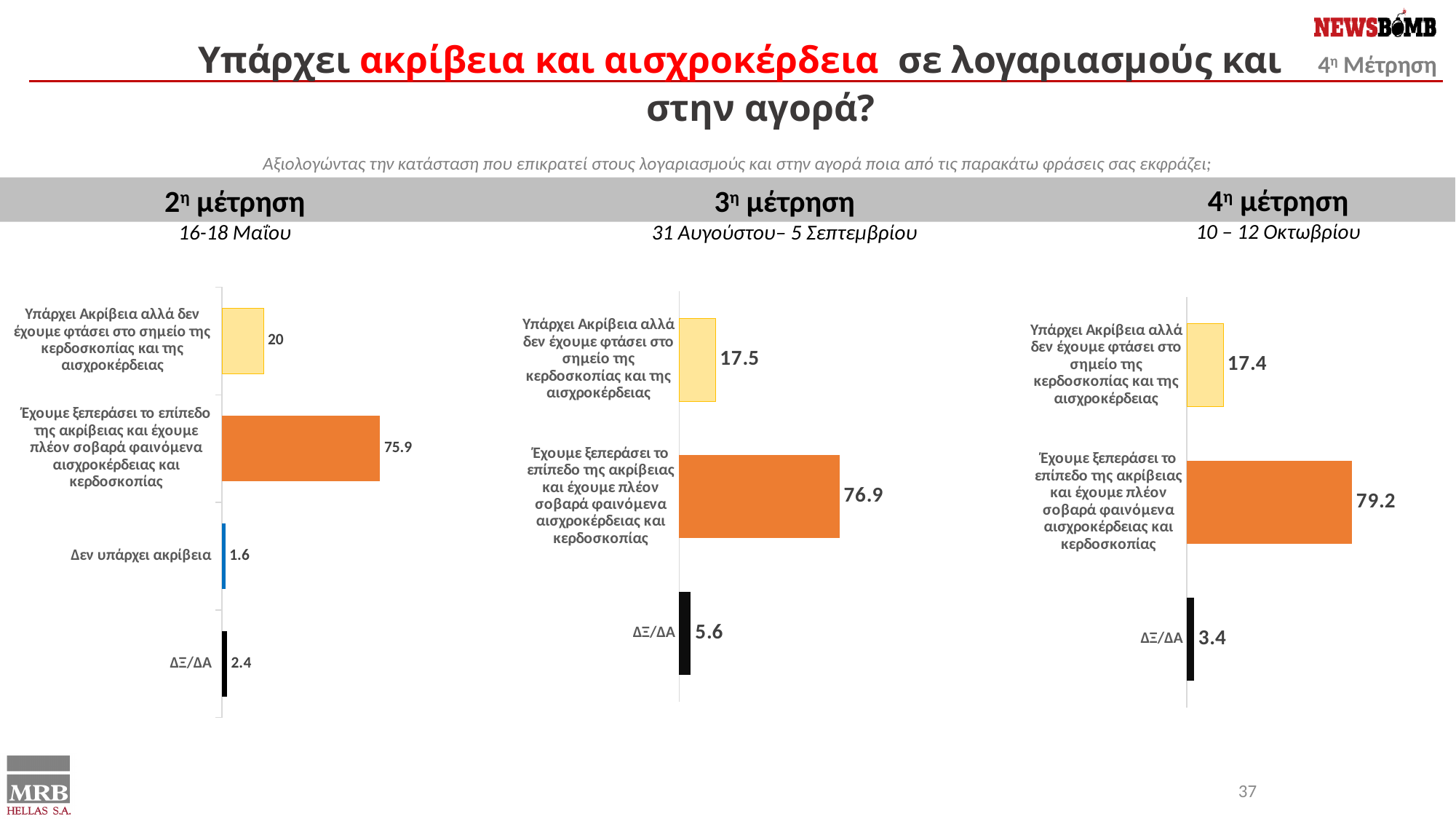
How many categories are shown in the 4η μέτρηση chart (right)? 3 In the 4η μέτρηση chart (right), what is the value for ΔΞ/ΔΑ? 3.4 In the 2η μέτρηση chart (left), what is the value for 'Έχουμε ξεπεράσει το επίπεδο της ακρίβειας και έχουμε πλέον σοβαρά φαινόμενα αισχροκέρδειας και κερδοσκοπίας'? 75.9 In the 4η μέτρηση chart (right), which category has the highest value? Έχουμε ξεπεράσει το επίπεδο της ακρίβειας και έχουμε πλέον σοβαρά φαινόμενα αισχροκέρδειας και κερδοσκοπίας In the 3η μέτρηση chart (middle), what is the value for 'Υπάρχει Ακρίβεια αλλά δεν έχουμε φτάσει στο σημείο της κερδοσκοπίας και της αισχροκέρδειας'? 17.5 Is the ΔΞ/ΔΑ value larger in the 3η μέτρηση chart (middle) or in the 4η μέτρηση chart (right)? 3η μέτρηση What type of chart is the 3η μέτρηση chart (middle)? Bar chart How many categories are shown in the 2η μέτρηση chart (left)? 4 In the 2η μέτρηση chart (left), which category has the lowest value? Δεν υπάρχει ακρίβεια In the 3η μέτρηση chart (middle), what is the difference between the value for 'Έχουμε ξεπεράσει το επίπεδο της ακρίβειας...' and the value for 'Υπάρχει Ακρίβεια αλλά δεν έχουμε φτάσει...'? 59.4 In the 2η μέτρηση chart (left), what is the value for 'Δεν υπάρχει ακρίβεια'? 1.6 What is the date range shown under the 4η μέτρηση chart (right)? 10 – 12 Οκτωβρίου